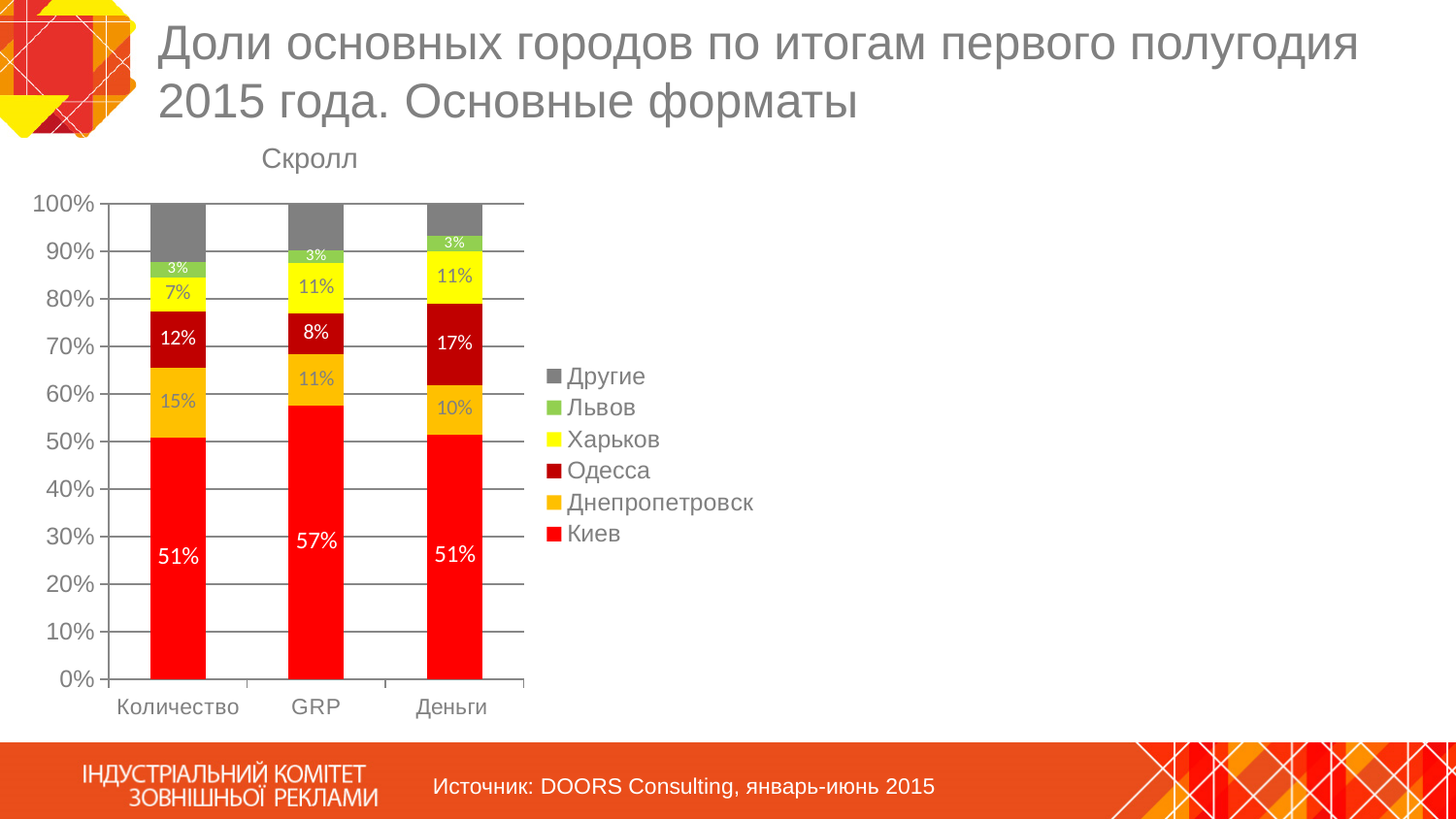
What kind of chart is shown on the slide? Stacked bar chart How many categories are shown on the x axis? 3 What is the title of the chart? Скролл What is the value for Харьков in the Количество bar? 7% In which category does Одесса have its lowest share? GRP What is the difference between the Одесса share in Деньги and in Количество? 5% What is the value for Днепропетровск in the GRP bar? 11% Which is larger: the Днепропетровск share in Количество or in Деньги? Количество What is the value for Одесса in the Деньги bar? 17% What is the value for Киев in the Количество bar? 51% In which category does Киев have its highest share? GRP How many series does the legend list? 6